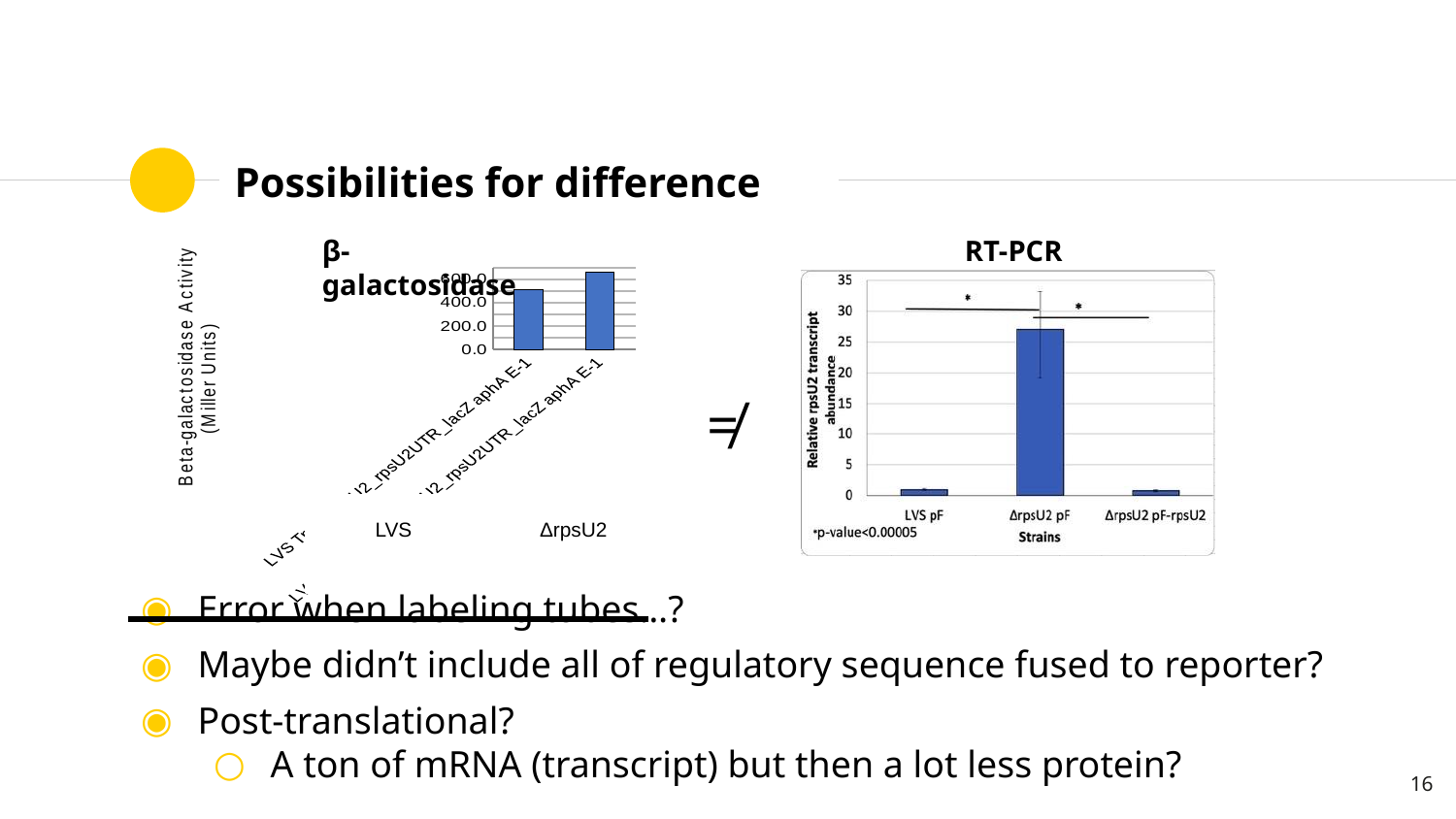
What kind of chart is the β-galactosidase chart? bar chart In the RT-PCR chart, which strain has the highest relative rpsU2 transcript abundance? ΔrpsU2 pF In the RT-PCR chart, is the value for LVS pF greater or less than 5? less In the RT-PCR chart, which is larger, the value for LVS pF or the value for ΔrpsU2 pF? ΔrpsU2 pF What kind of chart is the RT-PCR chart? bar chart In the RT-PCR chart, what is the title of the x axis? Strains In the RT-PCR chart, is the value for ΔrpsU2 pF greater or less than 20? greater In the β-galactosidase chart, which is larger, the value for LVS or the value for ΔrpsU2? ΔrpsU2 In the β-galactosidase chart, how many bars are plotted? 2 In the RT-PCR chart, how many strains are plotted on the x axis? 3 In the RT-PCR chart, what is the label of the y axis? Relative rpsU2 transcript abundance In the β-galactosidase chart, is the value for LVS greater or less than 400.0? greater